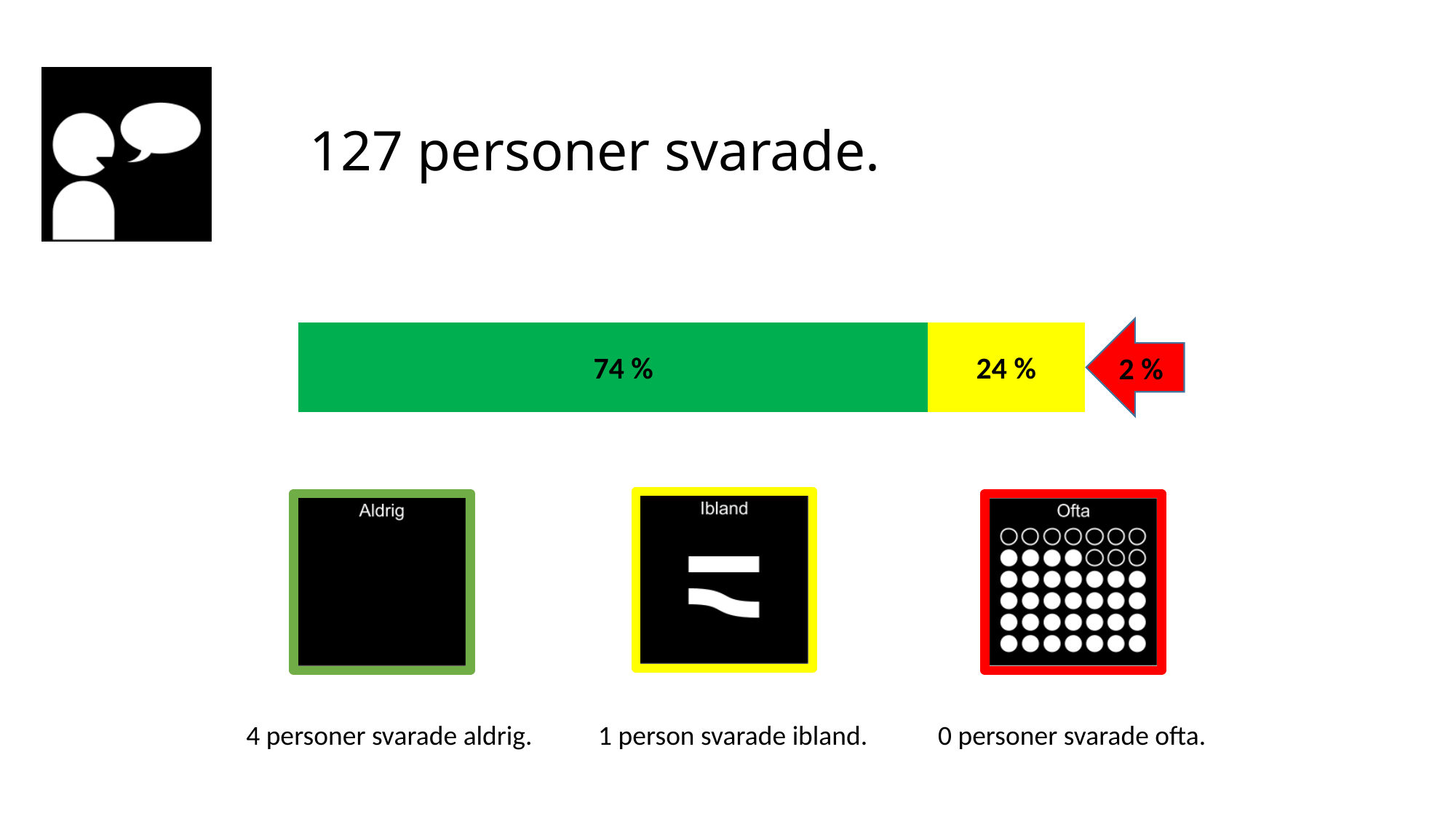
What value is shown on the yellow segment of the stacked bar? 24 % What is the total of all segments in the stacked bar? 100 % What colour is the segment labelled 24 %? Yellow How many segments does the stacked bar contain? 3 Which segment of the stacked bar has the largest value? The green segment (74 %) What kind of chart is shown on the slide? A stacked bar chart What value is shown on the green segment of the stacked bar? 74 % Which segment of the stacked bar has the smallest value? The red segment (2 %) Which is larger, the green segment or the yellow segment? The green segment What value does the red arrow indicate for the smallest segment of the bar? 2 % What is the difference between the yellow segment and the red segment? 22 % What is the difference between the green segment and the yellow segment? 50 %